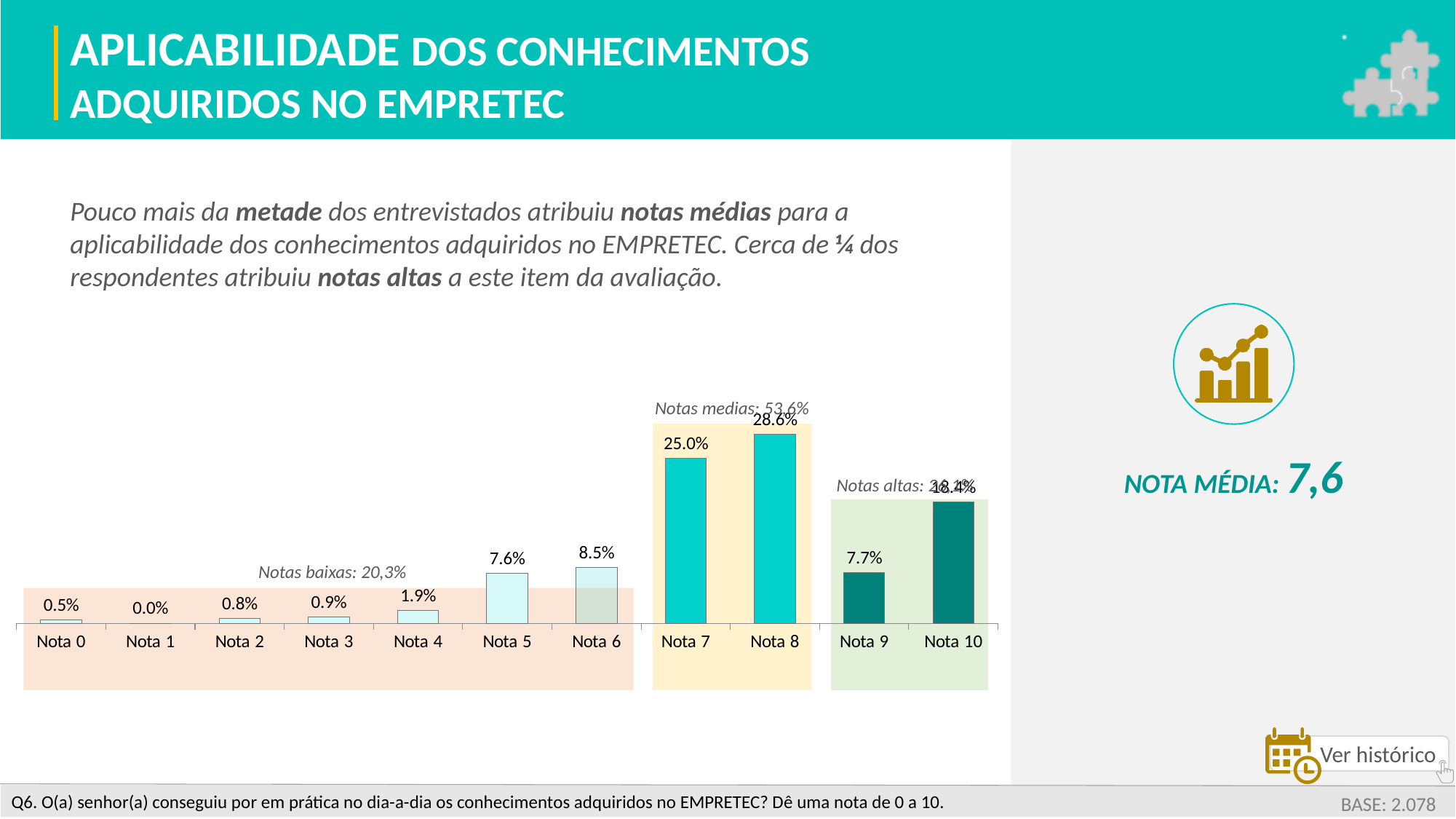
What is the 'Nota média' shown on the right side of the slide? 7,6 What percentage of respondents gave Nota 4? 1.9% What is the difference in percentage points between Nota 8 and Nota 7? 3.6 percentage points How many nota categories are shown on the x axis of the chart? 11 Which nota has the lowest percentage of respondents? Nota 1 What type of chart is used to show the distribution of notas? Bar chart Which has a higher percentage, Nota 5 or Nota 6? Nota 6 What percentage is shown for the 'Notas baixas' group on the chart? 20,3% What percentage of respondents gave Nota 7? 25.0% Which nota has the highest percentage of respondents? Nota 8 What percentage of respondents gave Nota 9? 7.7% What percentage of respondents gave Nota 8? 28.6%